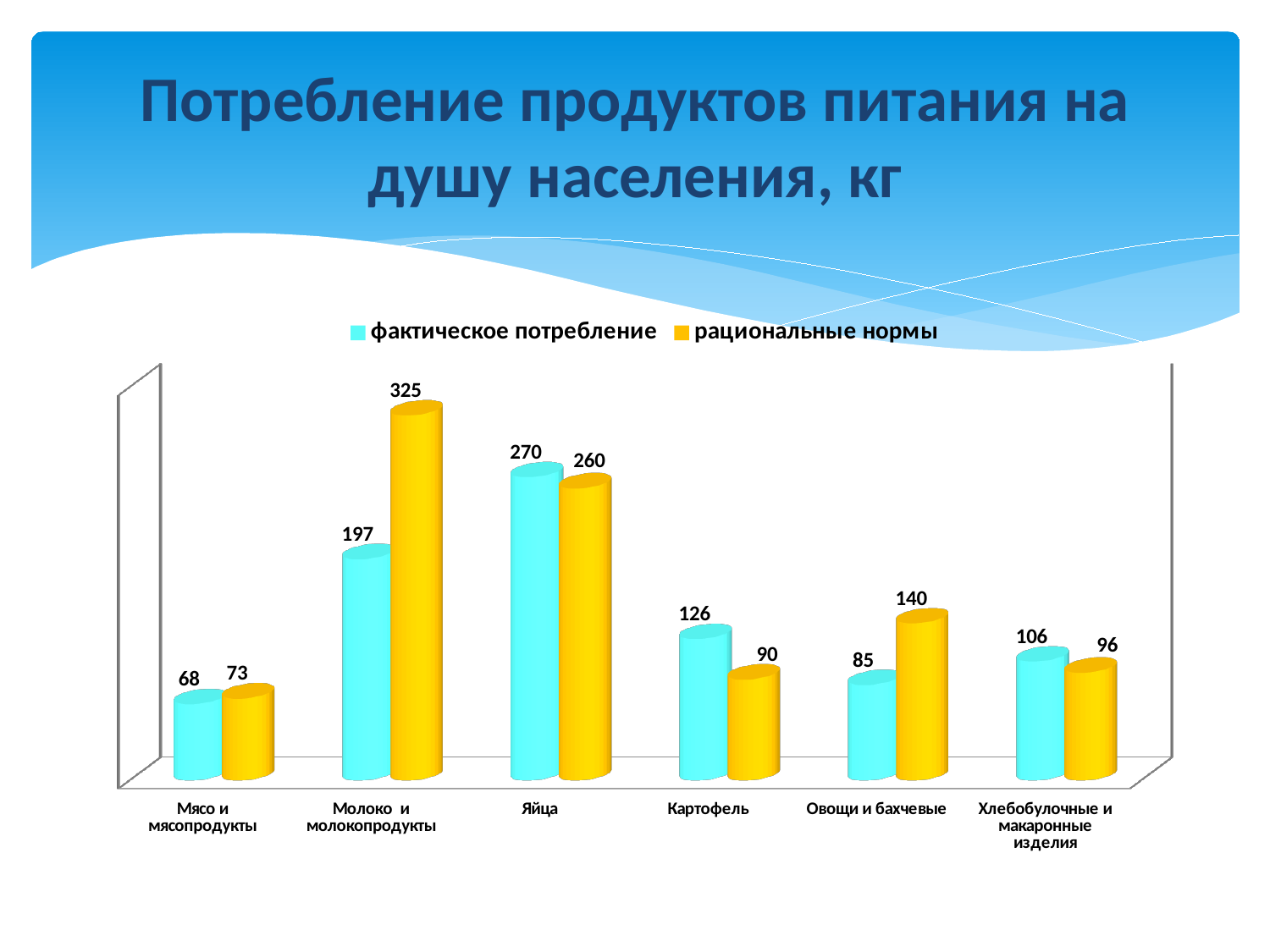
Which category has the lowest value for фактическое потребление? Мясо и мясопродукты What is the value of фактическое потребление for Яйца? 270 Which category has the highest value for рациональные нормы? Молоко и молокопродукты For Овощи и бахчевые, which is larger: фактическое потребление or рациональные нормы? рациональные нормы What is the value of фактическое потребление for Овощи и бахчевые? 85 How many series does the legend list? 2 What is the difference between фактическое потребление and рациональные нормы for Картофель? 36 What is the difference between рациональные нормы and фактическое потребление for Молоко и молокопродукты? 128 What colour are the bars for фактическое потребление? cyan What kind of chart is shown on the slide? bar chart How many categories are shown on the x axis? 6 What is the value of рациональные нормы for Молоко и молокопродукты? 325